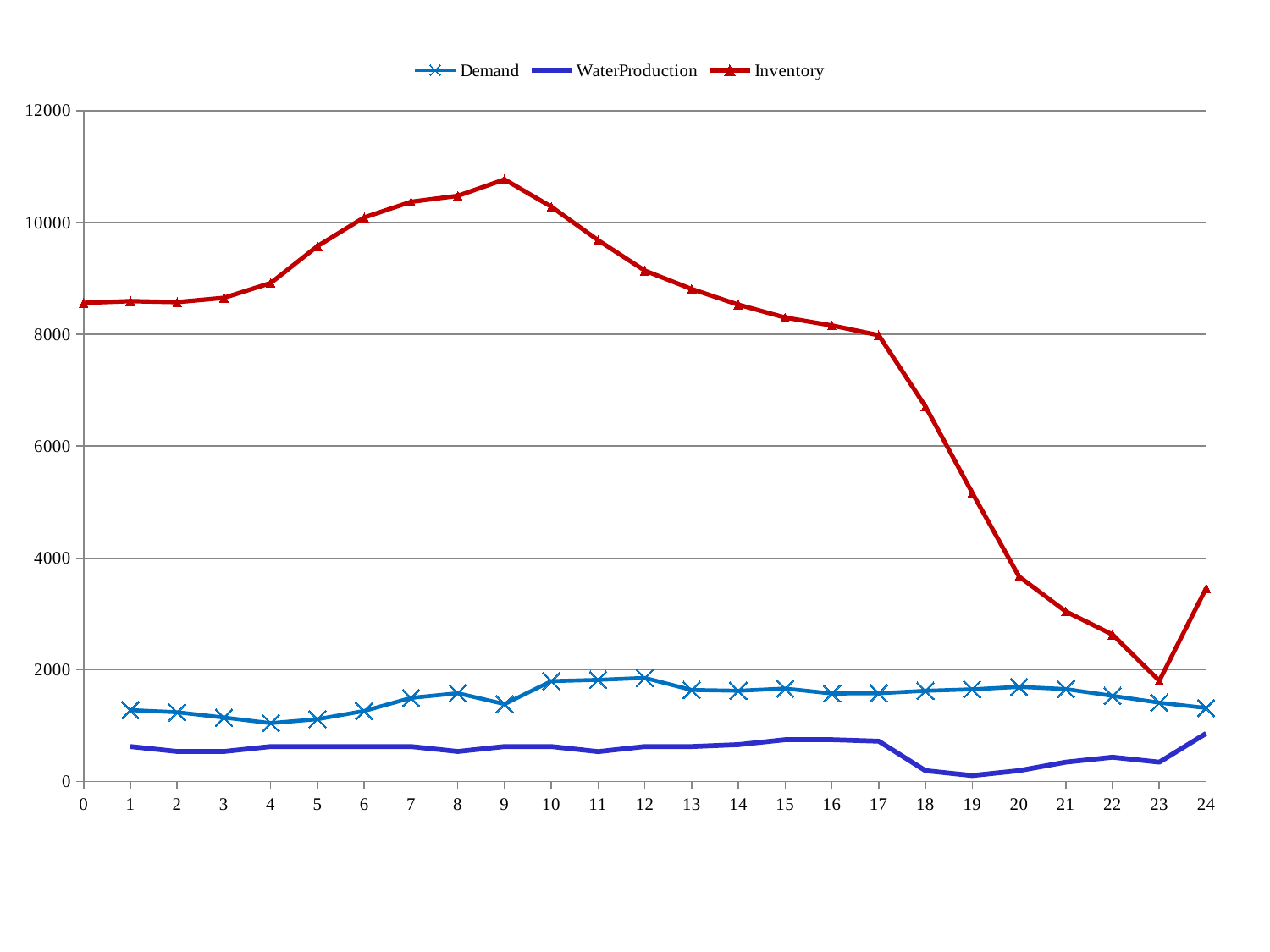
How many series does the legend list? 3 At which x value does the Inventory series reach its lowest point? 23 Is the Inventory value at x = 23 greater or less than 2000? less Which series is drawn in red? Inventory At which x value does the Inventory series reach its highest point? 9 Is the Inventory value at x = 9 greater or less than 10000? greater At x = 12, which series has the larger value, Demand or WaterProduction? Demand Which is larger: the Inventory value at x = 9 or at x = 17? x = 9 Does the Inventory series rise or fall between x = 17 and x = 23? fall Is the Demand value at x = 12 greater or less than 2000? less What kind of chart is shown on the slide? line chart